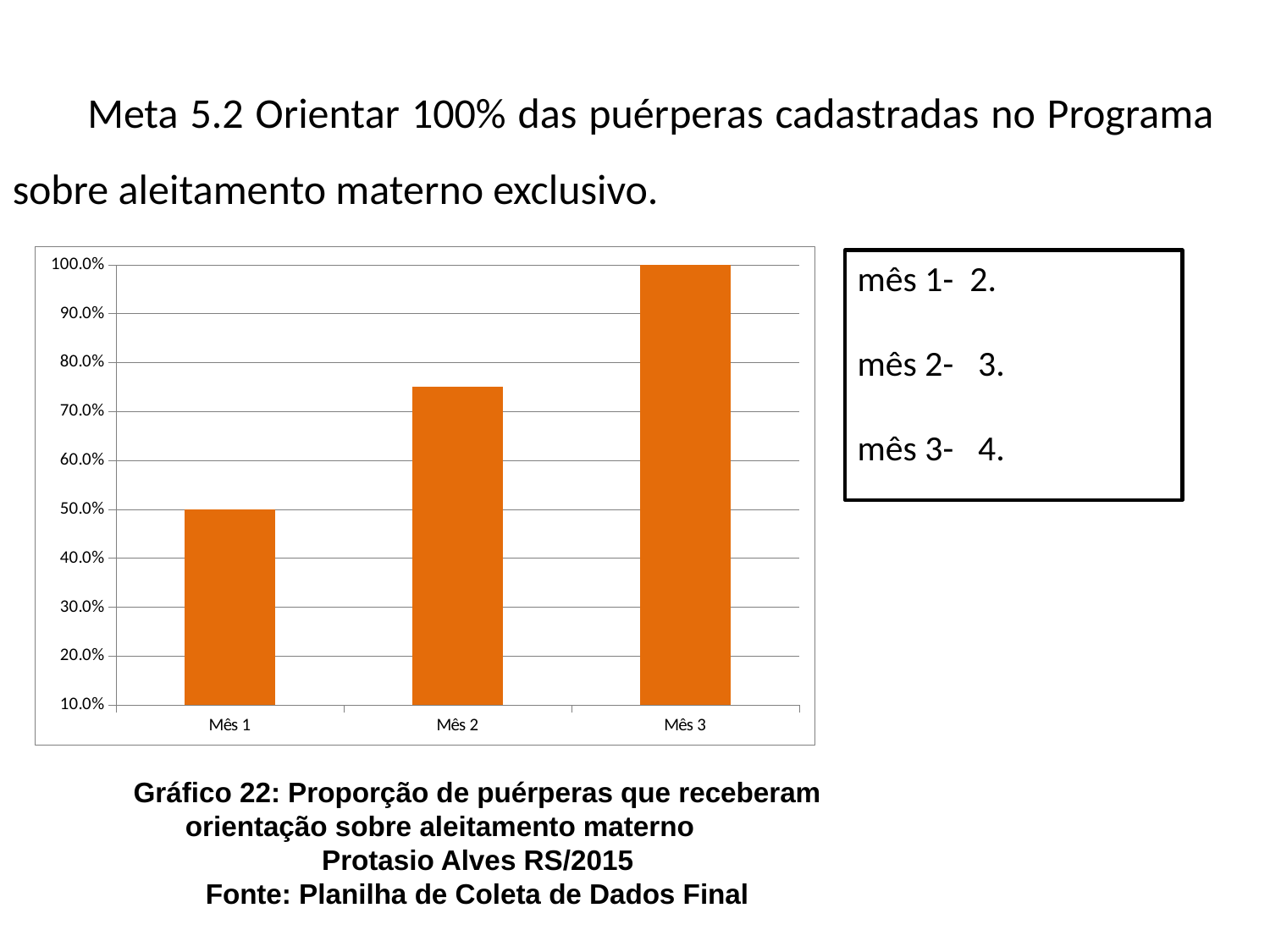
What is the difference between the values for Mês 3 and Mês 1? 50.0% Do the values rise or fall from Mês 1 to Mês 3? rise Which month has the highest value? Mês 3 How many months are shown on the x axis? 3 Which month has the lowest value? Mês 1 What is the value for Mês 1? 50.0% What kind of chart is shown on the slide? bar chart Which is larger, the value for Mês 1 or the value for Mês 2? Mês 2 Is the value for Mês 2 greater or less than 70.0%? greater What colour are the bars in the chart? orange What is the value for Mês 3? 100.0% Is the value for Mês 2 greater or less than 80.0%? less